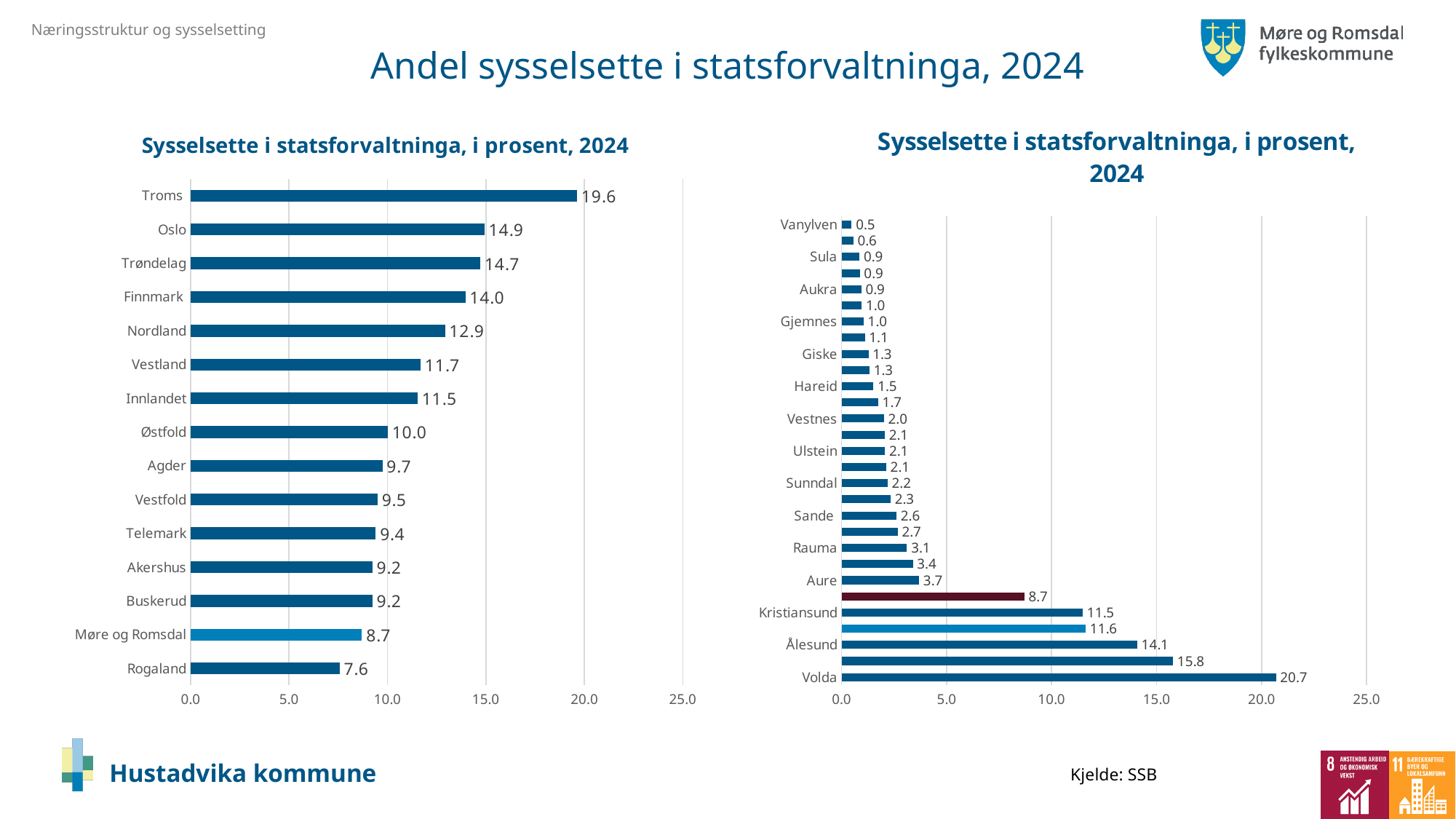
On the left chart, what is the difference between the values for Oslo and Trøndelag? 0.2 On the left chart, which is larger, the value for Nordland or the value for Vestland? Nordland On the left chart, which category has the highest value? Troms How many categories are shown on the left chart? 15 On the left chart, what is the value for Troms? 19.6 What kind of chart is the left chart? Bar chart On the left chart, what is the value for Møre og Romsdal? 8.7 On the right chart, what is the difference between the values for Ålesund and Kristiansund? 2.6 On the right chart, which category has the highest value? Volda On the right chart, what is the value for Kristiansund? 11.5 On the right chart, what is the value for Volda? 20.7 On the left chart, which category has the lowest value? Rogaland